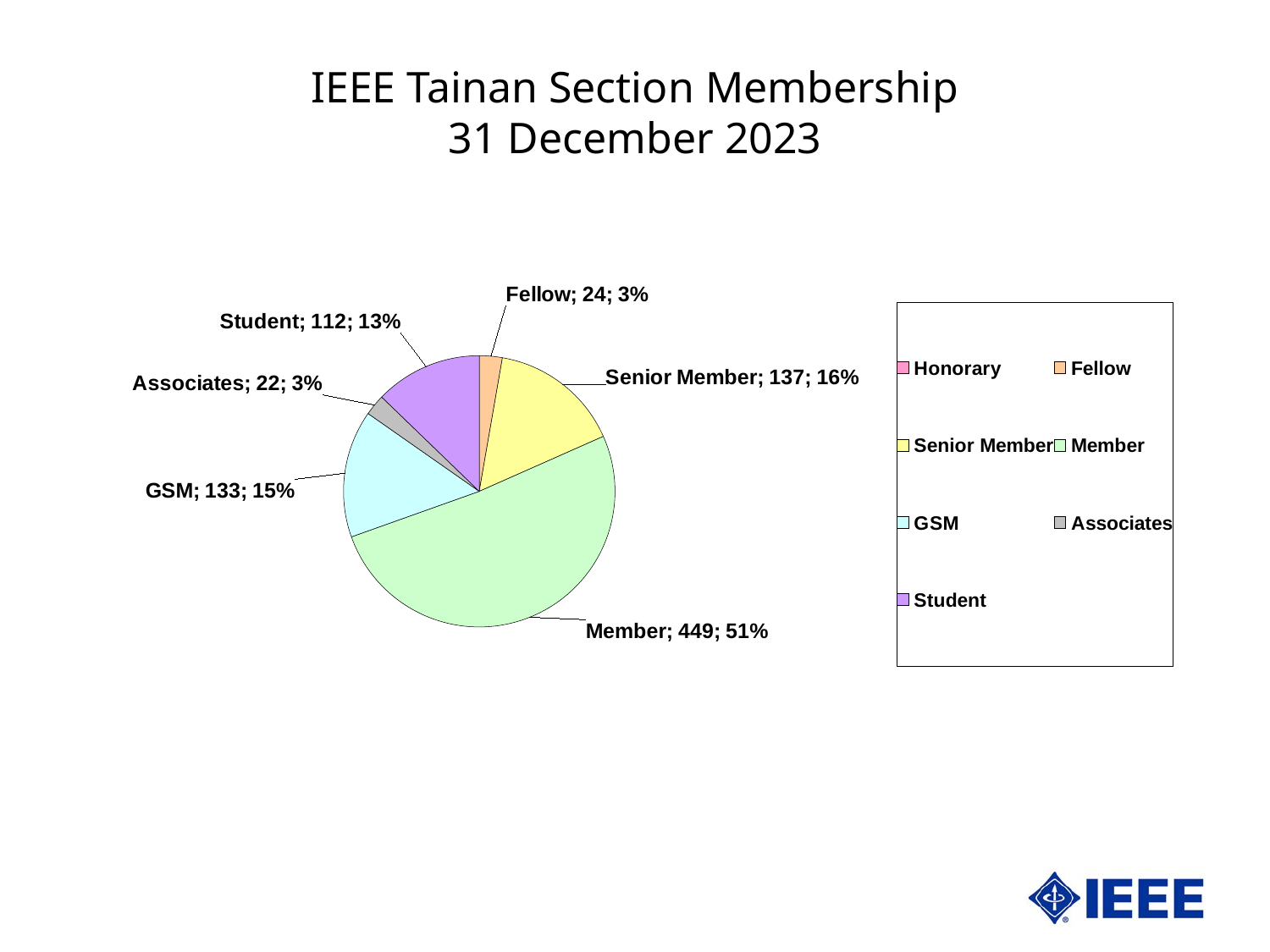
What is the difference between the Senior Member value and the GSM value? 4 Which is larger, the Student value or the Fellow value? Student What is the value shown for Senior Member? 137 Which of the labelled categories has the smallest value? Associates What percentage share of the pie does the Student slice represent? 13% What kind of chart is shown on the slide? pie chart What is the value shown for GSM? 133 How many members are in the Member category? 449 What is the value shown for Associates? 22 What percentage share of the pie does the Member slice represent? 51% Which category has the largest slice of the pie? Member How many categories does the legend list? 7